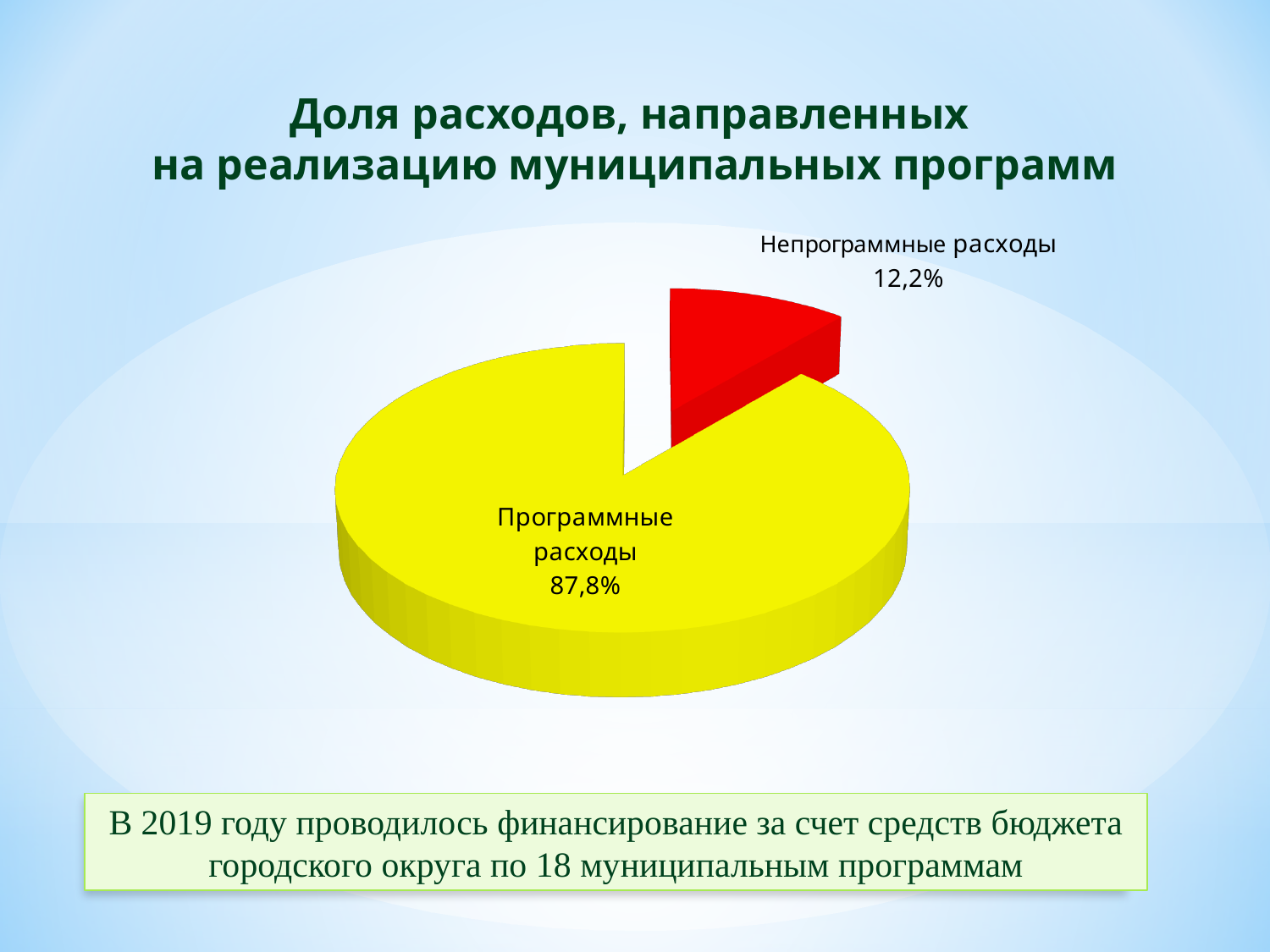
How many slices does the pie chart have? 2 What colour is the "Программные расходы" slice? Yellow What share of the pie is labelled "Непрограммные расходы"? 12,2% What is the combined share of the two slices in the pie chart? 100% What colour is the "Непрограммные расходы" slice? Red Which slice of the pie is the smallest? Непрограммные расходы What share of the pie is labelled "Программные расходы"? 87,8% What kind of chart is shown on the slide? Pie chart What is the difference in percentage points between the "Программные расходы" and "Непрограммные расходы" slices? 75,6 Which slice of the pie is the largest? Программные расходы Which is larger: the share for "Программные расходы" or for "Непрограммные расходы"? Программные расходы